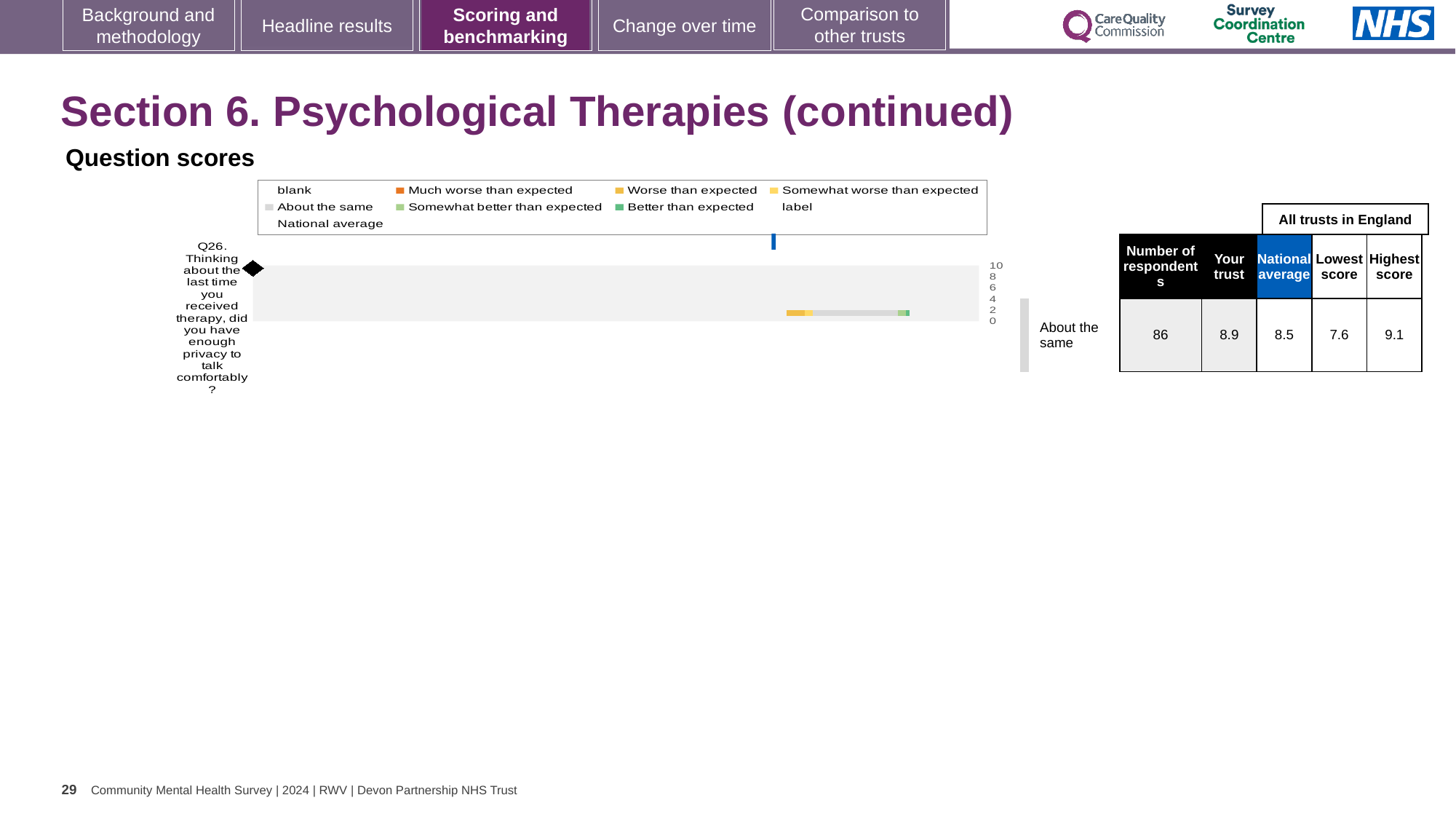
What is the national average score for Q26 in the table beside the chart? 8.5 How many respondents answered Q26? 86 What is the lowest score among all trusts in England for Q26? 7.6 What is the difference between the 'Your trust' score and the national average for Q26? 0.4 What is the benchmark category shown for Q26 next to the chart? About the same Which question is shown on the chart? Q26. Thinking about the last time you received therapy, did you have enough privacy to talk comfortably? What is the highest score among all trusts in England for Q26? 9.1 What is the 'Your trust' score for Q26 in the table beside the chart? 8.9 Is the 'Your trust' score for Q26 higher or lower than the national average? higher What is the maximum value shown on the chart's numeric axis? 10 What is the difference between the highest and lowest scores among all trusts in England for Q26? 1.5 How many survey questions are plotted on the chart? 1